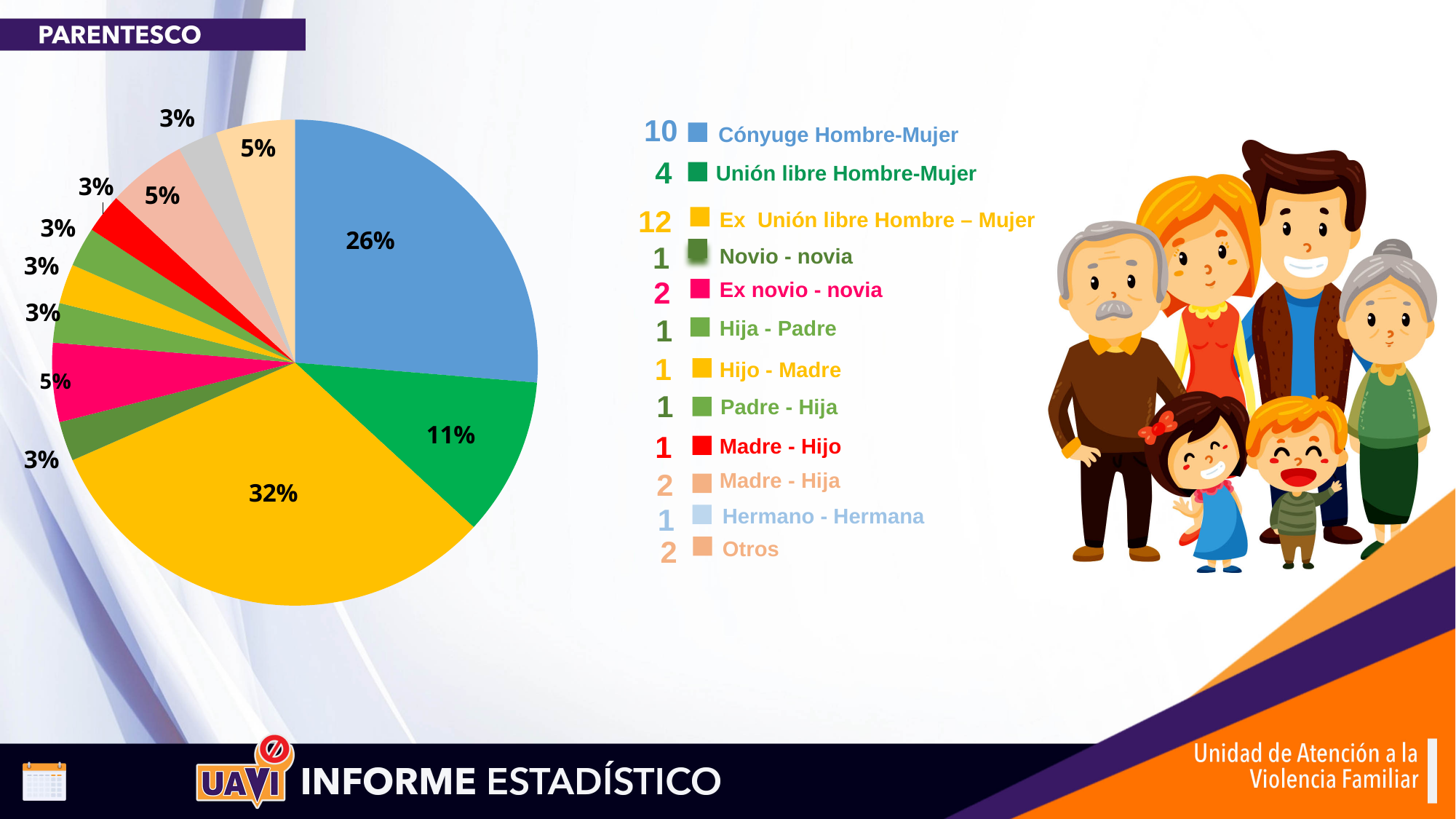
What type of chart is shown on the slide? pie chart What percentage of the pie does Cónyuge Hombre-Mujer represent? 26% What count is shown in the legend for Ex Unión libre Hombre – Mujer? 12 What is the title of the chart? PARENTESCO Which is larger, the slice for Cónyuge Hombre-Mujer or the slice for Unión libre Hombre-Mujer? Cónyuge Hombre-Mujer What count is shown in the legend for Cónyuge Hombre-Mujer? 10 What count is shown in the legend for Unión libre Hombre-Mujer? 4 What percentage of the pie does Unión libre Hombre-Mujer represent? 11% What is the difference in percentage points between the Ex Unión libre Hombre – Mujer slice (32%) and the Cónyuge Hombre-Mujer slice (26%)? 6% What percentage of the pie does Ex Unión libre Hombre – Mujer represent? 32% Which category has the largest slice of the pie? Ex Unión libre Hombre – Mujer How many categories does the legend of the pie chart list? 12